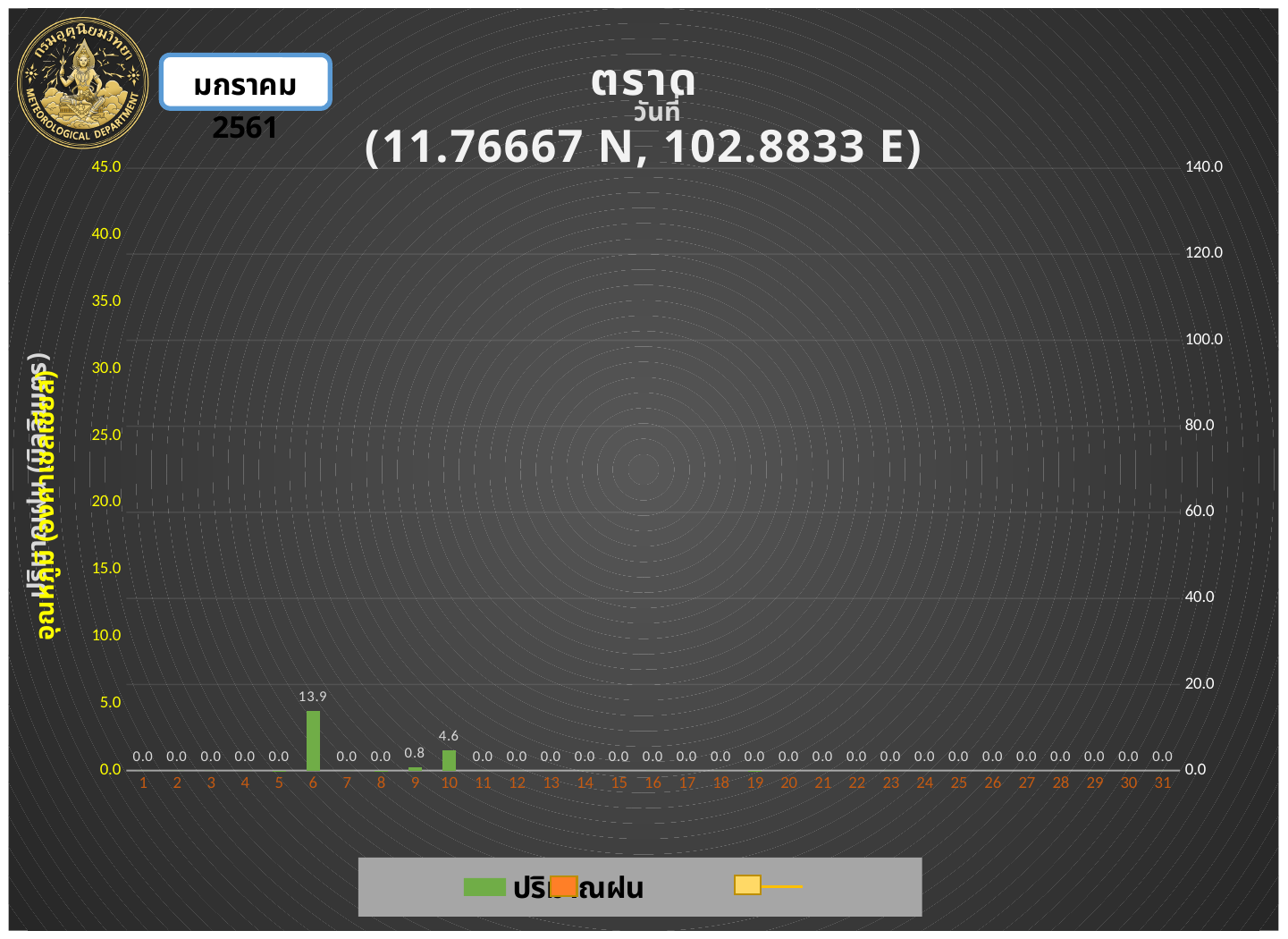
What kind of chart is this? bar chart What is the rainfall value shown for day 1? 0.0 What is the difference between the rainfall values for day 6 and day 10? 9.3 How many days are shown on the x axis? 31 What is the rainfall value shown for day 9? 0.8 What coordinates are shown in the chart title? (11.76667 N, 102.8833 E) What is the rainfall value shown for day 6? 13.9 Which day has the larger rainfall value, day 9 or day 10? 10 What is the difference between the rainfall values for day 6 and day 9? 13.1 What is the rainfall value shown for day 10? 4.6 Which day has the highest rainfall value? 6 What station name is shown in the chart title? ตราด